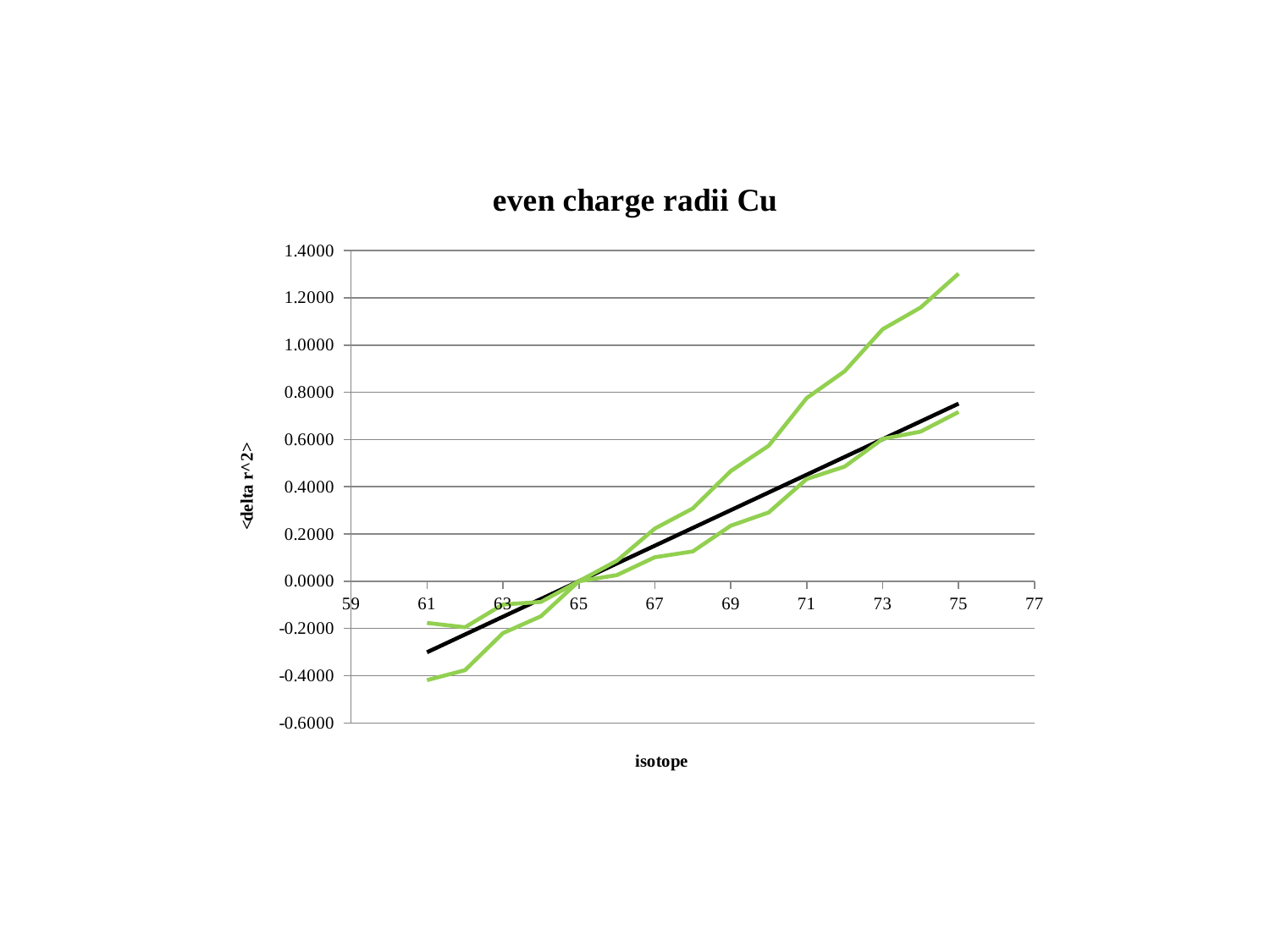
What is the title of the chart? even charge radii Cu How many lines are plotted on the chart? 3 Is the value of the upper green line at isotope 75 greater or less than 1.2000? greater What kind of chart is shown on the slide? line chart Is the value of the lower green line at isotope 61 greater or less than -0.2000? less Is the value of the lower green line at isotope 69 greater or less than 0.4000? less Do the plotted values rise or fall as the isotope number increases? rise At isotope 75, which line has the larger value, the upper green line or the black straight line? the upper green line What value do all three lines pass through at isotope 65? 0.0000 What is the label of the x axis? isotope